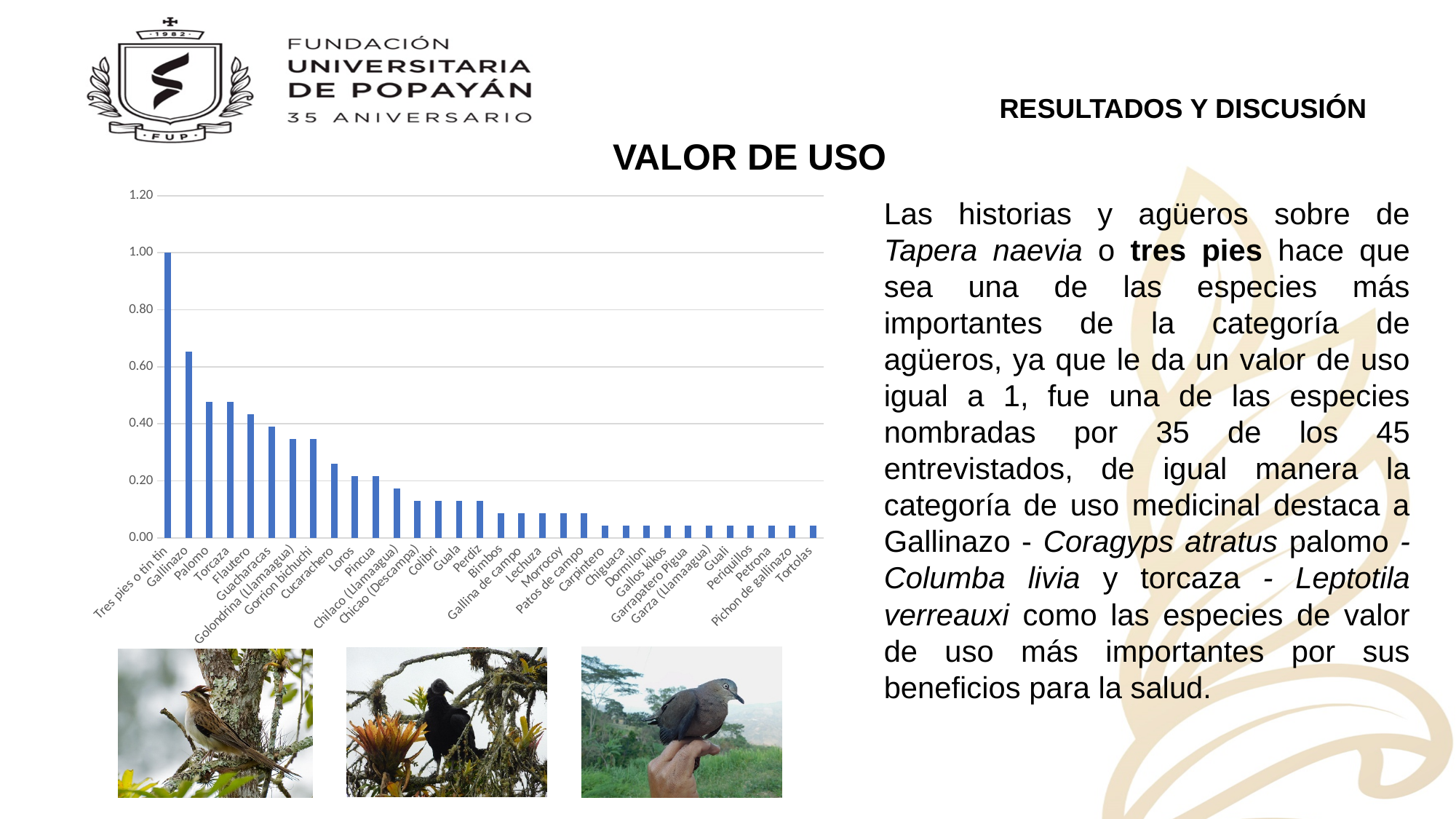
Is the value for Colibri greater or less than 0.20? less What is the value for Tres pies o tin tin? 1.00 What kind of chart is shown on the slide? bar chart Which category has the highest value in the chart? Tres pies o tin tin Is the value for Tortolas greater or less than 0.20? less Do the values rise or fall from left to right along the x axis? fall Is the value for Palomo greater or less than 0.40? greater How many categories are shown on the x axis of the chart? 32 Which has a larger value, Gallinazo or Palomo? Gallinazo What is the title of the chart? VALOR DE USO